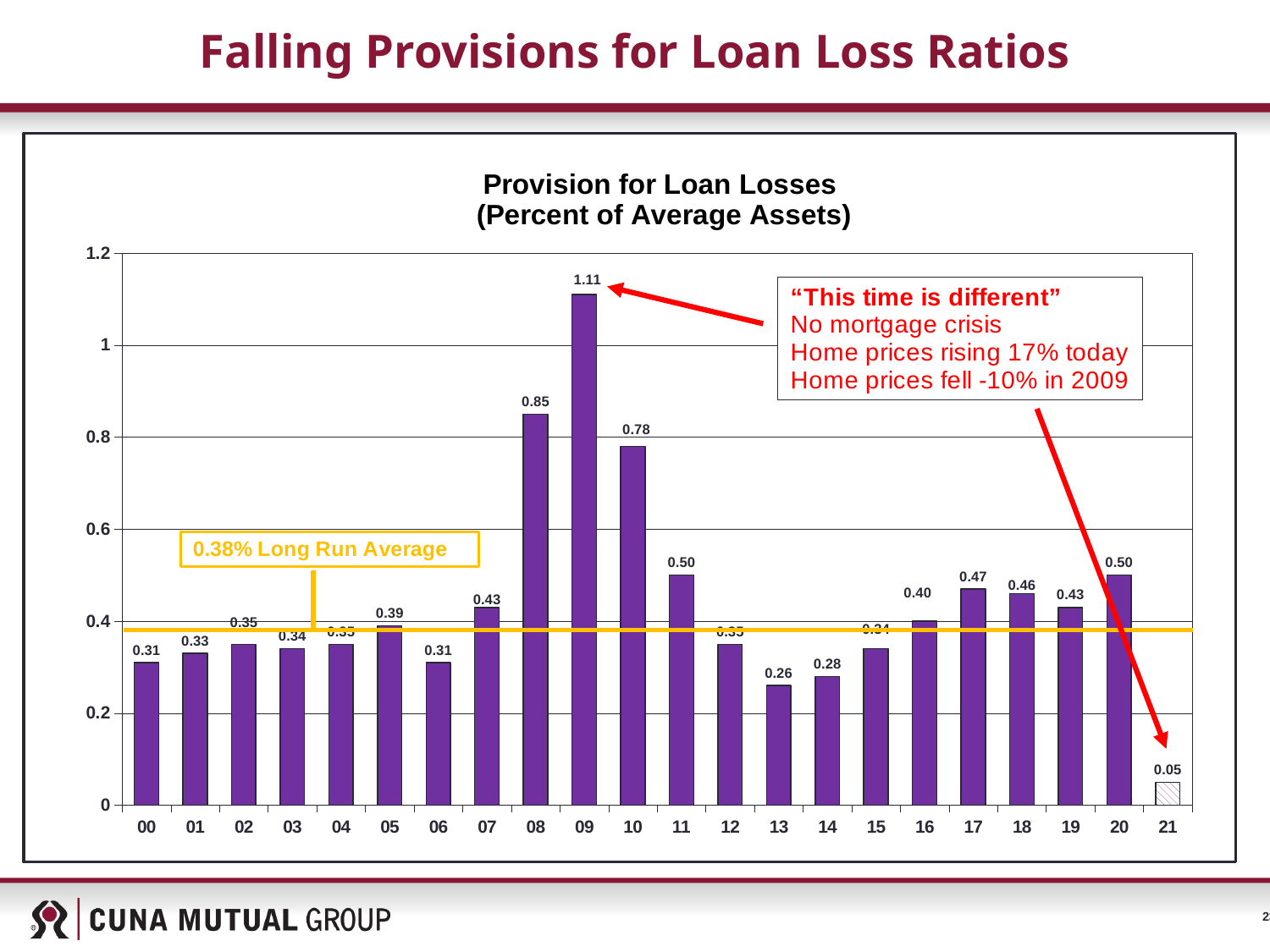
What is the value for 09 in the Provision for Loan Losses chart? 1.11 What is the difference between the values for 09 and 08? 0.26 Which year has the lowest provision for loan losses? 21 What long run average is marked by the horizontal line on the chart? 0.38% How many years are shown on the x axis of the chart? 22 What is the difference between the values for 20 and 21? 0.45 What kind of chart is shown on the slide? bar chart Which is larger, the value for 17 or the value for 18? 17 What is the value for 21 in the Provision for Loan Losses chart? 0.05 Is the value for 10 greater or less than 0.6? greater What is the value for 13 in the Provision for Loan Losses chart? 0.26 Which year has the highest provision for loan losses? 09